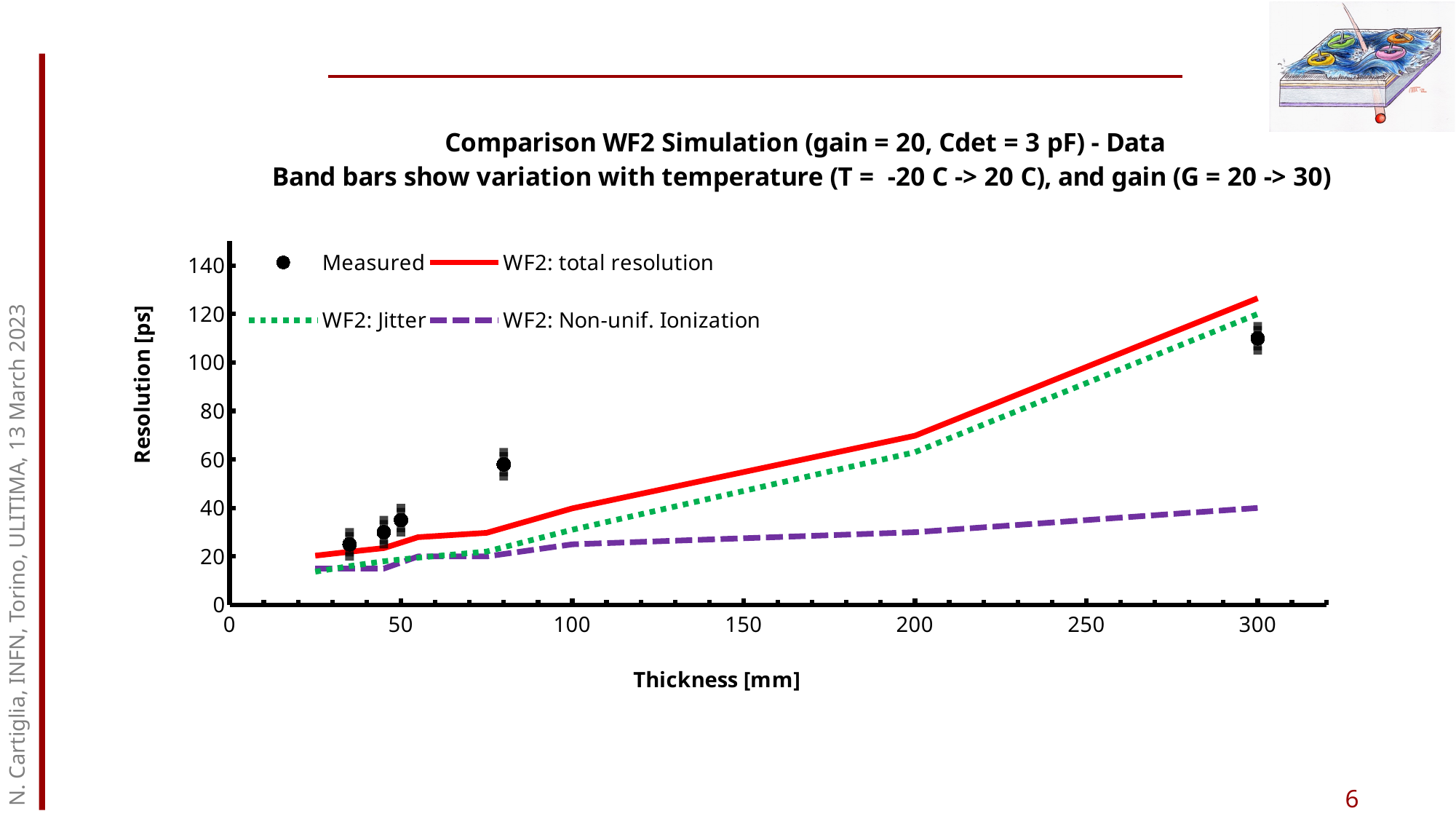
Is the Measured value at 300 mm thickness greater or less than 100? greater What kind of chart is shown on the slide? line chart How many series does the chart legend list? 4 At 300 mm thickness, which is higher: WF2: total resolution or WF2: Non-unif. Ionization? WF2: total resolution At 200 mm thickness, which is higher: WF2: Jitter or WF2: Non-unif. Ionization? WF2: Jitter Does the WF2: total resolution line rise or fall as thickness increases? rise Is the WF2: total resolution value at 300 mm thickness greater or less than 100? greater Is the WF2: Non-unif. Ionization value at 300 mm thickness greater or less than 60? less What is the label of the y axis? Resolution [ps] Which series has the highest value at 300 mm thickness? WF2: total resolution How many Measured data points are plotted on the chart? 5